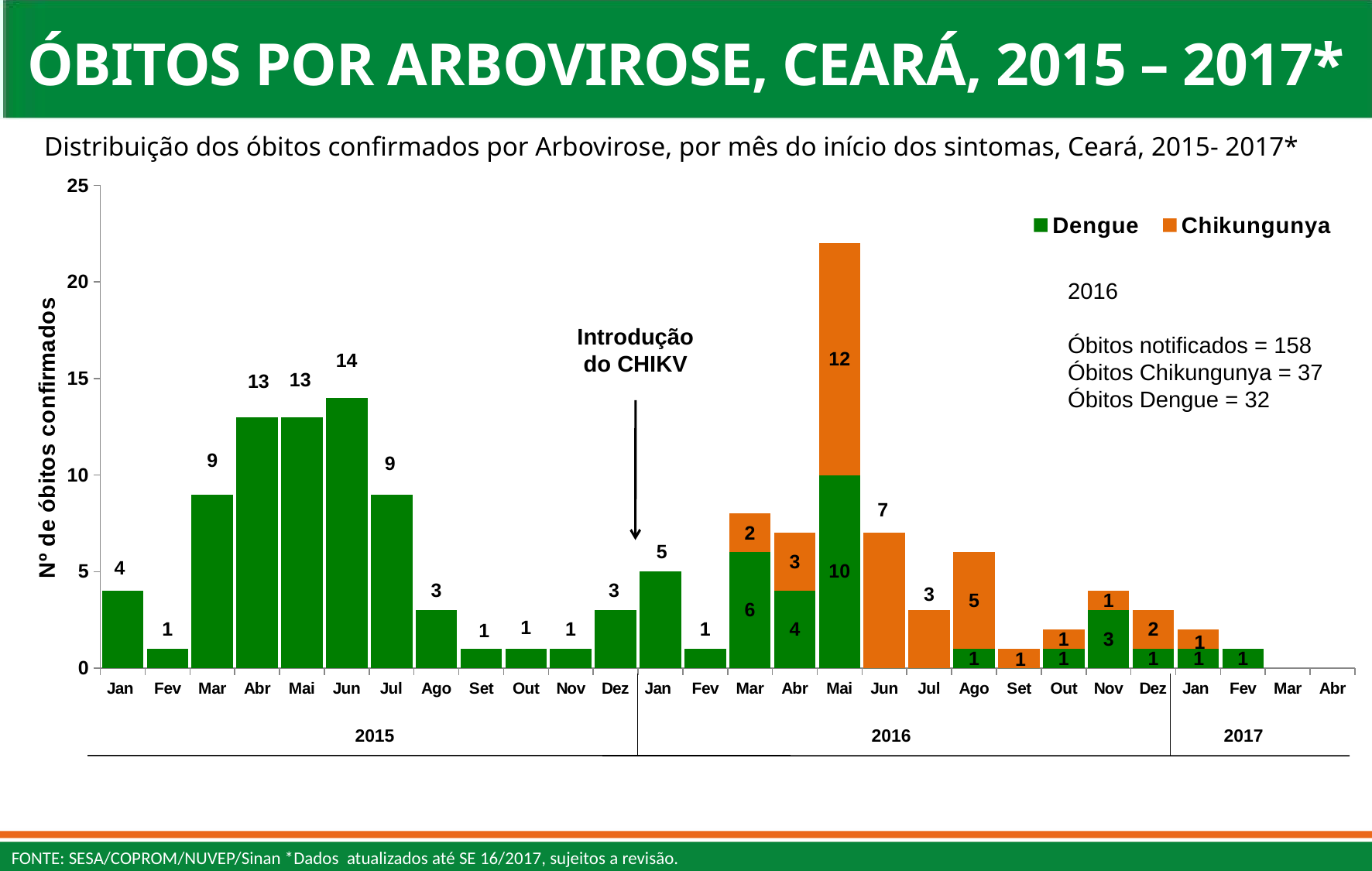
How many series does the legend list? 2 How many Chikungunya deaths are shown for Jun 2016? 7 Is the total value of the Mai 2016 bar greater or less than 20? greater What is the total number of deaths (Dengue plus Chikungunya) in the Mai 2016 bar? 22 What is the difference between the Dengue deaths in Abr 2015 and Jan 2015? 9 Which has more Dengue deaths, Mar 2016 or Abr 2016? Mar 2016 How many Dengue deaths are shown for Jun 2015? 14 What kind of chart is shown on the slide? Stacked bar chart Which month has the highest total bar in the chart? Mai 2016 Which colour represents Chikungunya in the legend? Orange How many Chikungunya deaths are shown for Mai 2016? 12 What is the total number of deaths in the Mar 2016 bar? 8